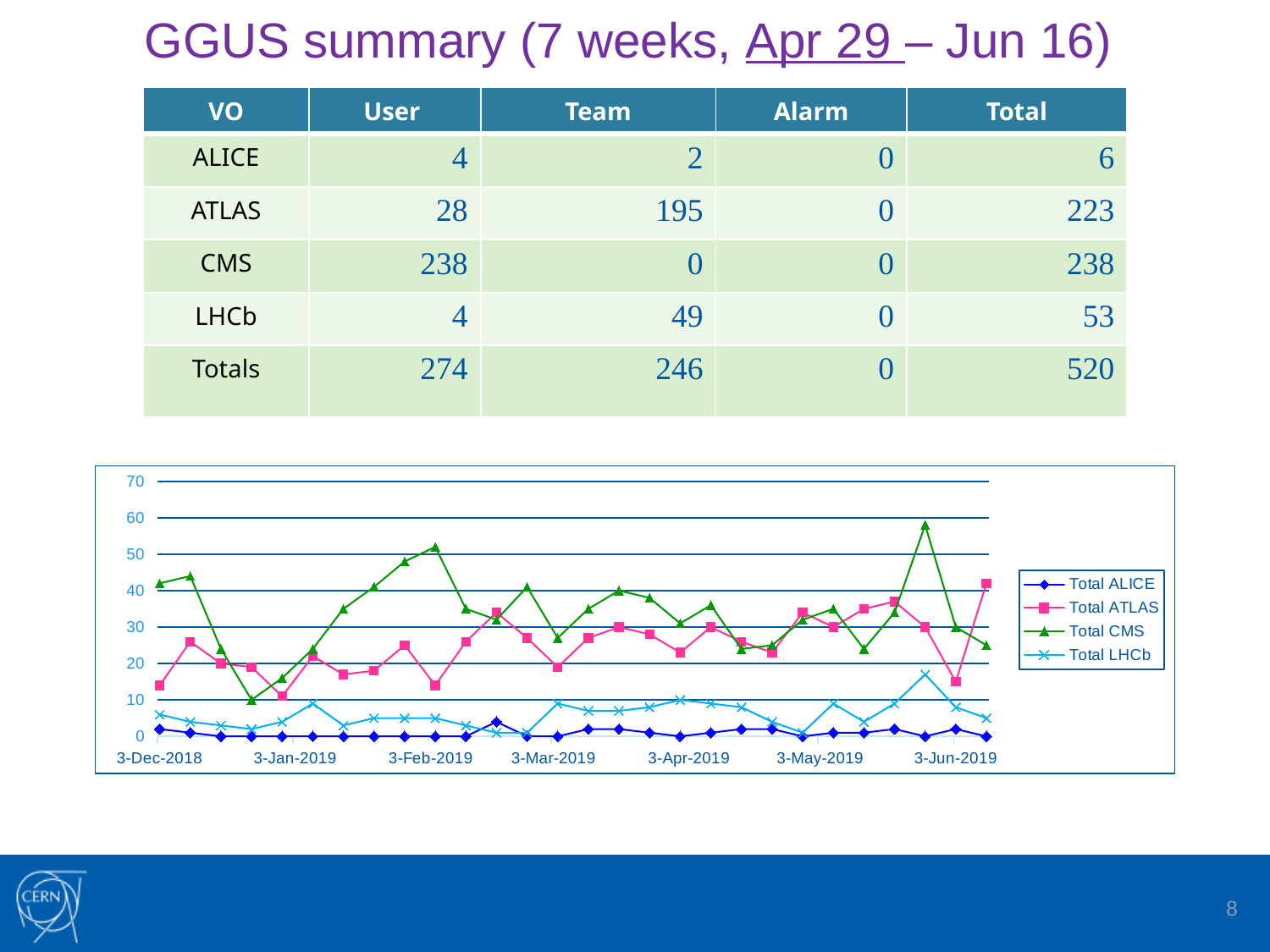
How many date labels are shown on the x axis of the line chart? 7 At 3-Jun-2019, which is larger in the line chart: Total CMS or Total ATLAS? Total CMS Which series in the line chart reaches the highest value? Total CMS Which series in the line chart stays lowest across the whole period? Total ALICE Is the highest value of Total LHCb in the line chart greater or less than 20? less What kind of chart is shown at the bottom of the slide? line chart How many series does the legend of the line chart list? 4 Is the value of Total ATLAS at 3-Dec-2018 greater or less than 20? less Is the value of Total CMS at 3-Dec-2018 greater or less than 30? greater What is the highest value shown on the y axis of the line chart? 70 What colour is the Total CMS line in the chart? green